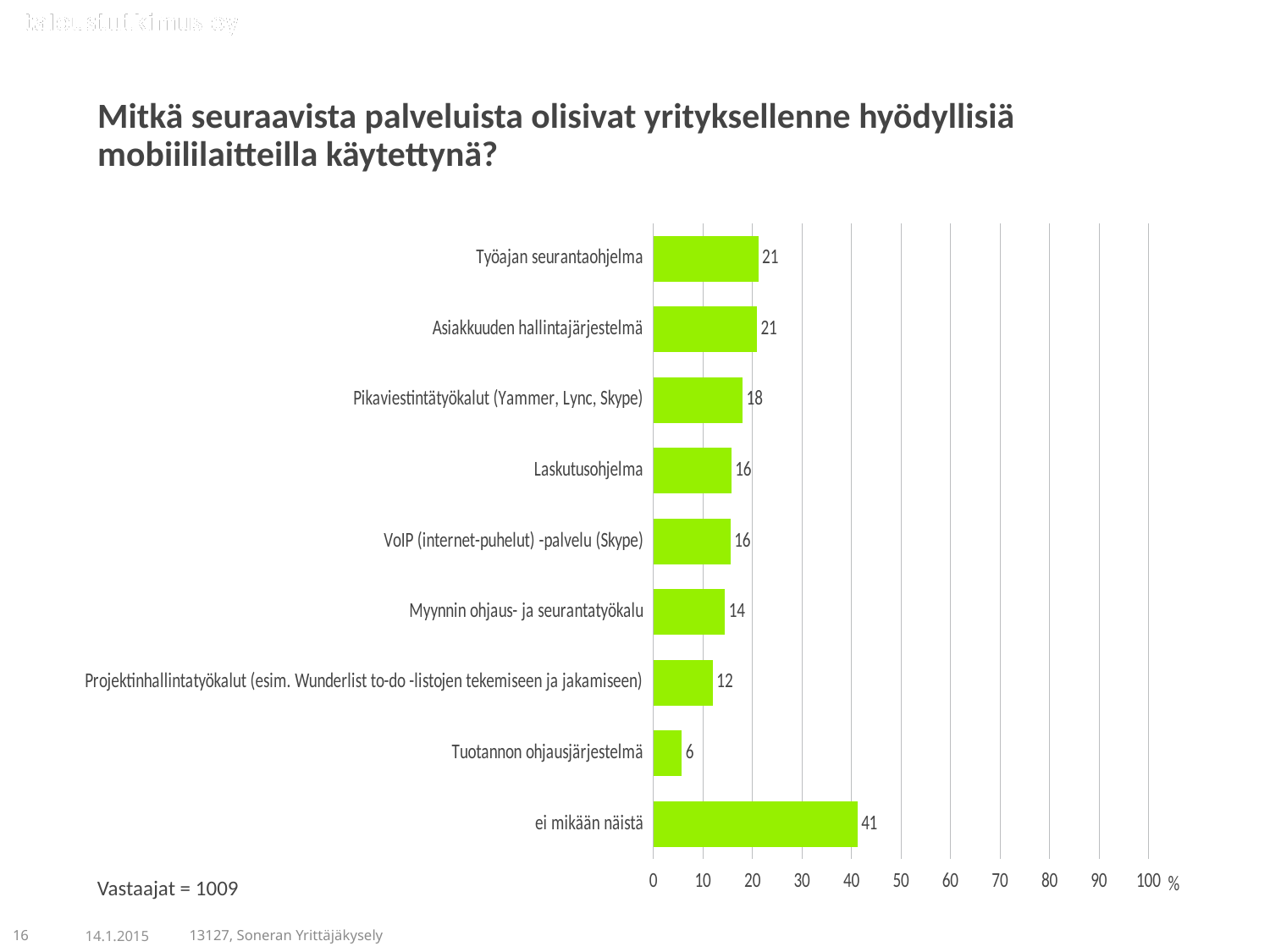
What is the value for Laskutusohjelma? 16 What is the value for Tuotannon ohjausjärjestelmä? 6 Which is larger, the value for Myynnin ohjaus- ja seurantatyökalu or the value for Projektinhallintatyökalut (esim. Wunderlist to-do -listojen tekemiseen ja jakamiseen)? Myynnin ohjaus- ja seurantatyökalu What kind of chart is shown on the slide? bar chart What is the value for Pikaviestintätyökalut (Yammer, Lync, Skype)? 18 Which category has the highest value? ei mikään näistä How many categories are shown in the chart? 9 What is the difference between the values for ei mikään näistä and Työajan seurantaohjelma? 20 What is the maximum value shown on the x axis? 100 Is the value for ei mikään näistä greater or less than 30? greater Which category has the lowest value? Tuotannon ohjausjärjestelmä What is the value for Asiakkuuden hallintajärjestelmä? 21